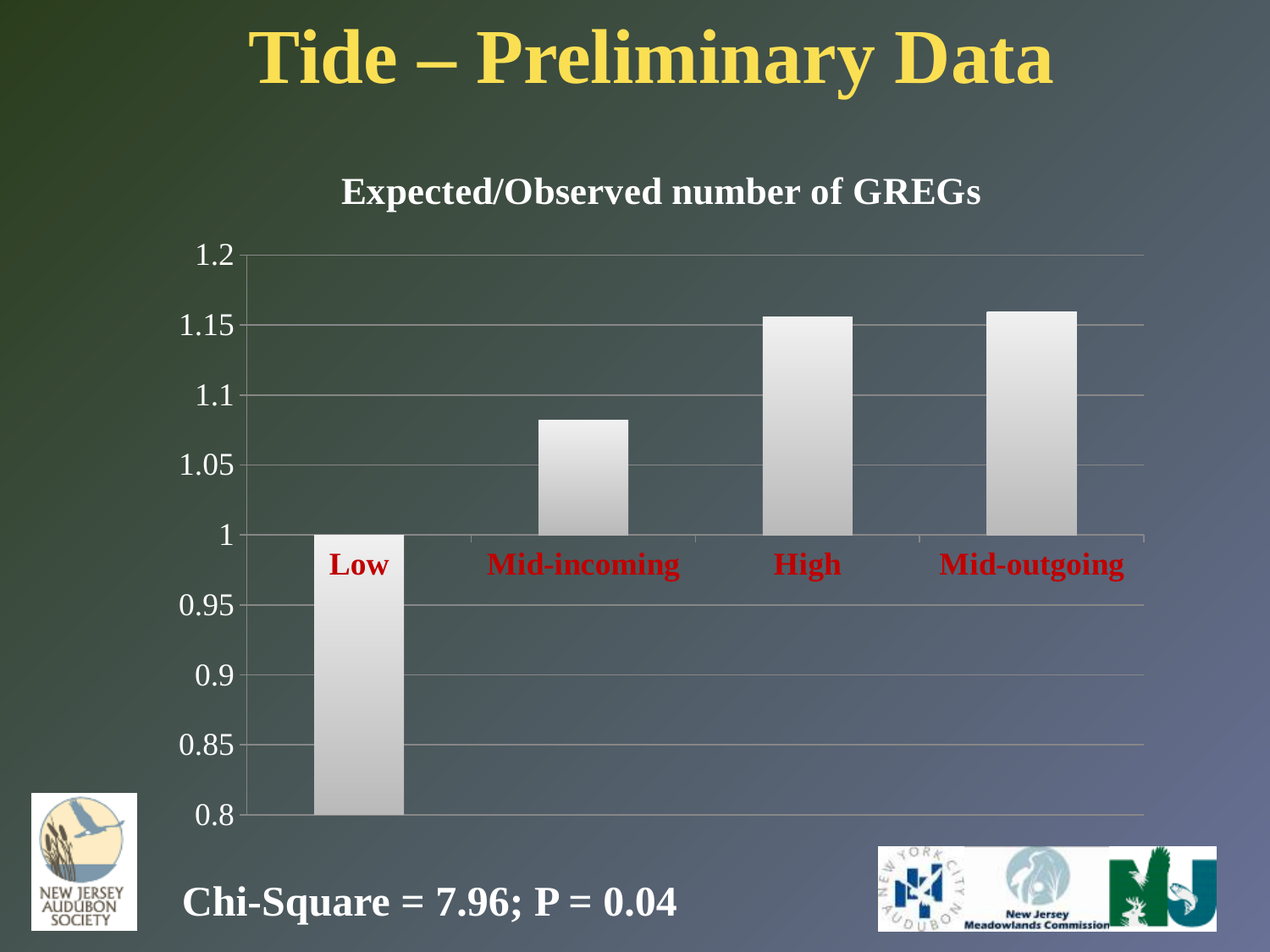
Is the value for Mid-incoming greater or less than 1.05? greater Is the value for Low greater or less than 0.9? less What kind of chart is shown on the slide? bar chart Is the value for Low greater or less than 1? less Which has the larger value, Mid-incoming or High? High How many of the tide categories have a value above 1? 3 What is the title of the chart? Expected/Observed number of GREGs How many tide categories are plotted in the chart? 4 Which tide category has the lowest value in the chart? Low